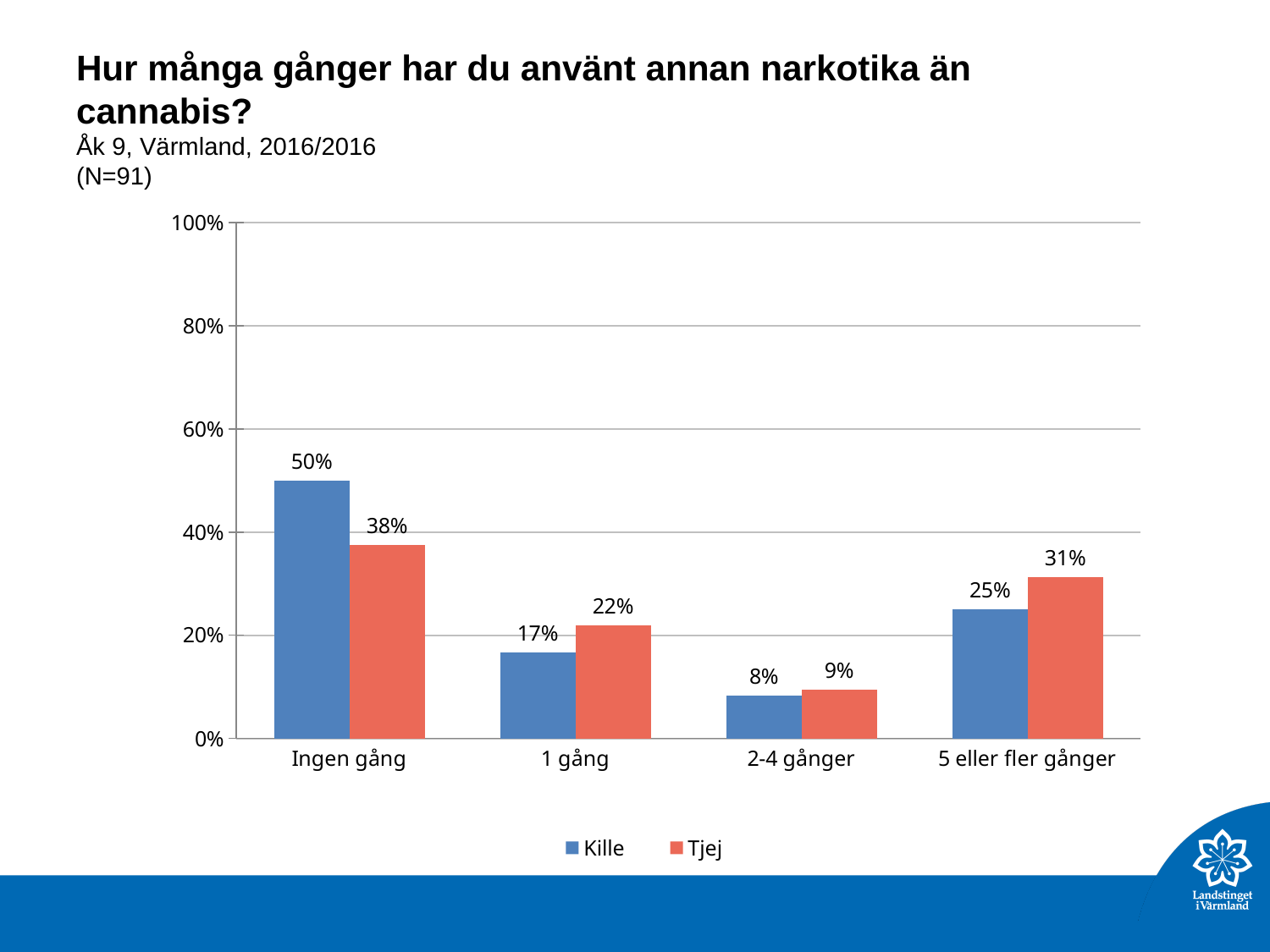
What is the difference between Kille and Tjej in the "Ingen gång" category? 12% What is the value for Tjej in the "5 eller fler gånger" category? 31% How many series does the legend list? 2 How many categories are shown on the x axis? 4 Which category has the highest value for Kille? Ingen gång What is the value for Tjej in the "1 gång" category? 22% What are the two series named in the legend? Kille and Tjej What is the value for Kille in the "Ingen gång" category? 50% Which category has the lowest value for Tjej? 2-4 gånger Is the value for Kille in the "1 gång" category greater or less than 20%? less What kind of chart is shown on the slide? bar chart In the "5 eller fler gånger" category, which series has the larger value, Kille or Tjej? Tjej